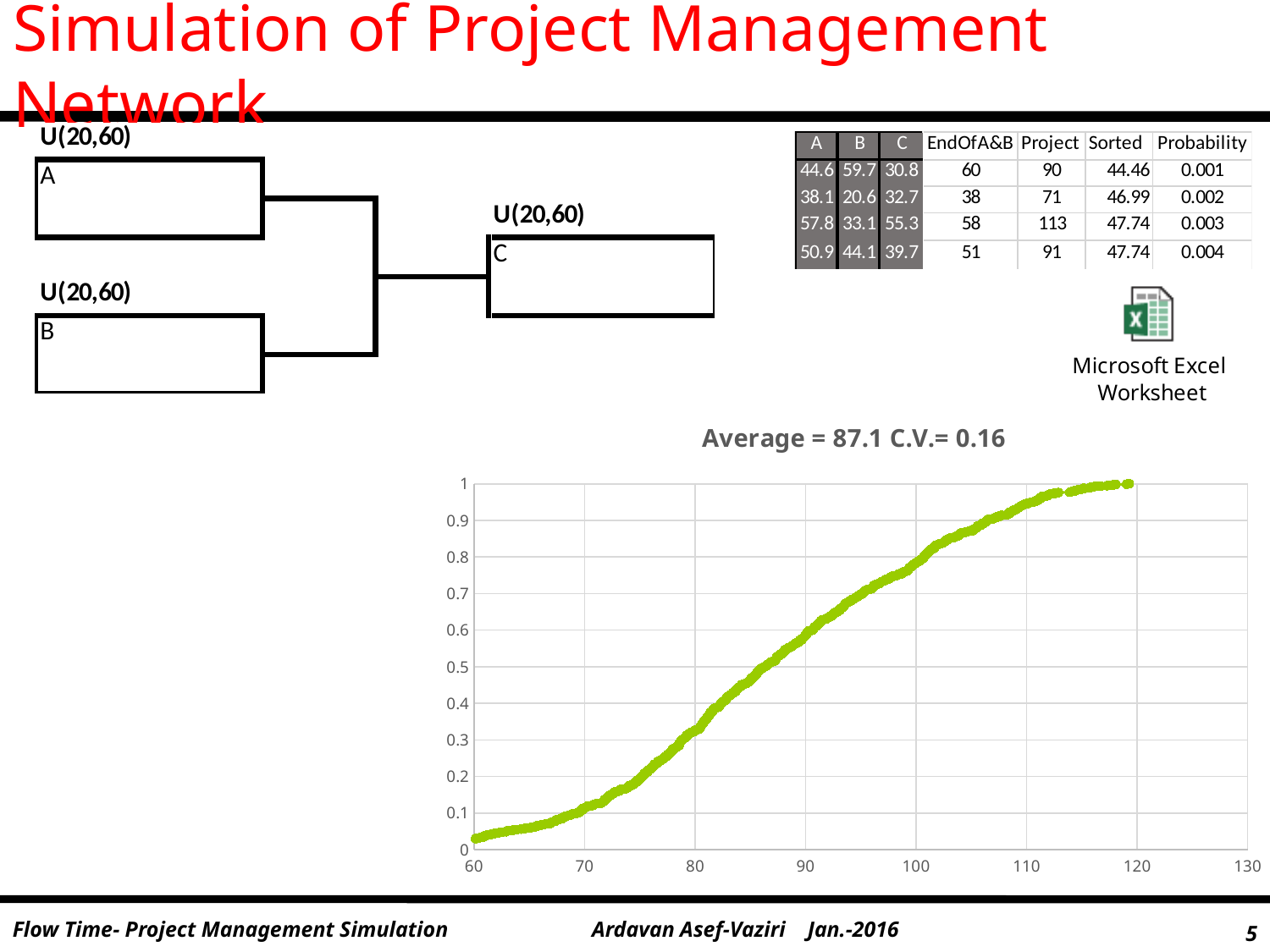
Is the plotted value at x = 120 greater or less than 0.9? greater Is the plotted value at x = 70 greater or less than 0.2? less What kind of chart is shown on the slide? scatter chart Do the plotted values rise or fall as the x axis increases from 60 to 120? rise Is the plotted value at x = 110 greater or less than 0.8? greater Which is larger, the plotted value at x = 90 or the plotted value at x = 110? x = 110 What is the title of the chart on the slide? Average = 87.1 C.V.= 0.16 What is the highest value shown on the chart's x axis? 130